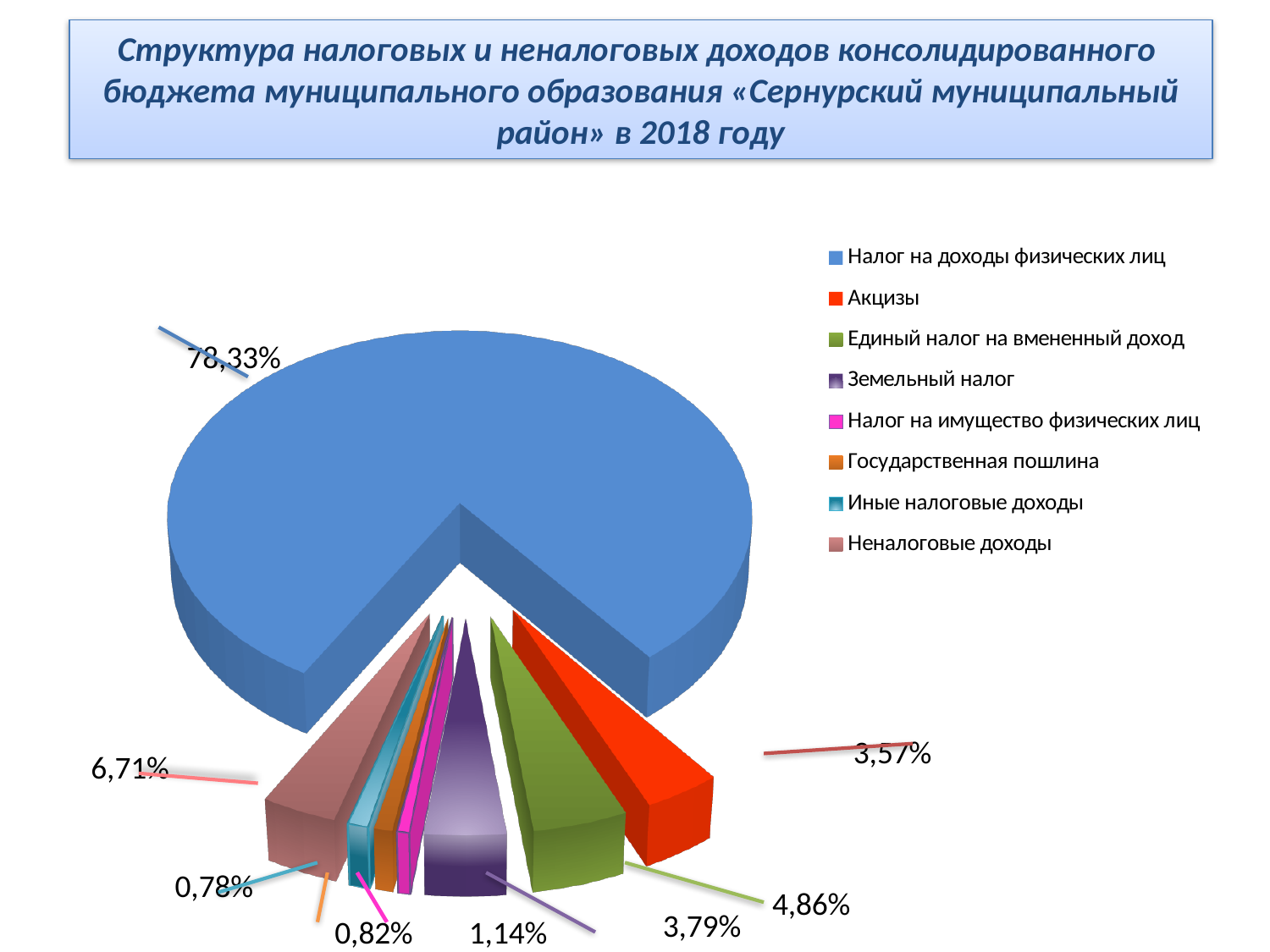
What is the difference in percentage points between Единый налог на вмененный доход and Акцизы? 1,29% Which slice is larger: Неналоговые доходы or Единый налог на вмененный доход? Неналоговые доходы What share of the pie is labelled for Иные налоговые доходы? 0,78% What share of the pie is labelled for Единый налог на вмененный доход? 4,86% What share of the pie is labelled for Неналоговые доходы? 6,71% What kind of chart is shown on the slide? pie chart What colour is the slice for Акцизы in the pie chart? red What is the difference in percentage points between Налог на доходы физических лиц and Неналоговые доходы? 71,62% Which category has the largest slice of the pie? Налог на доходы физических лиц What share of the pie is labelled for Акцизы? 3,57% How many categories does the legend of the pie chart list? 8 What share of the pie is labelled for Налог на доходы физических лиц? 78,33%